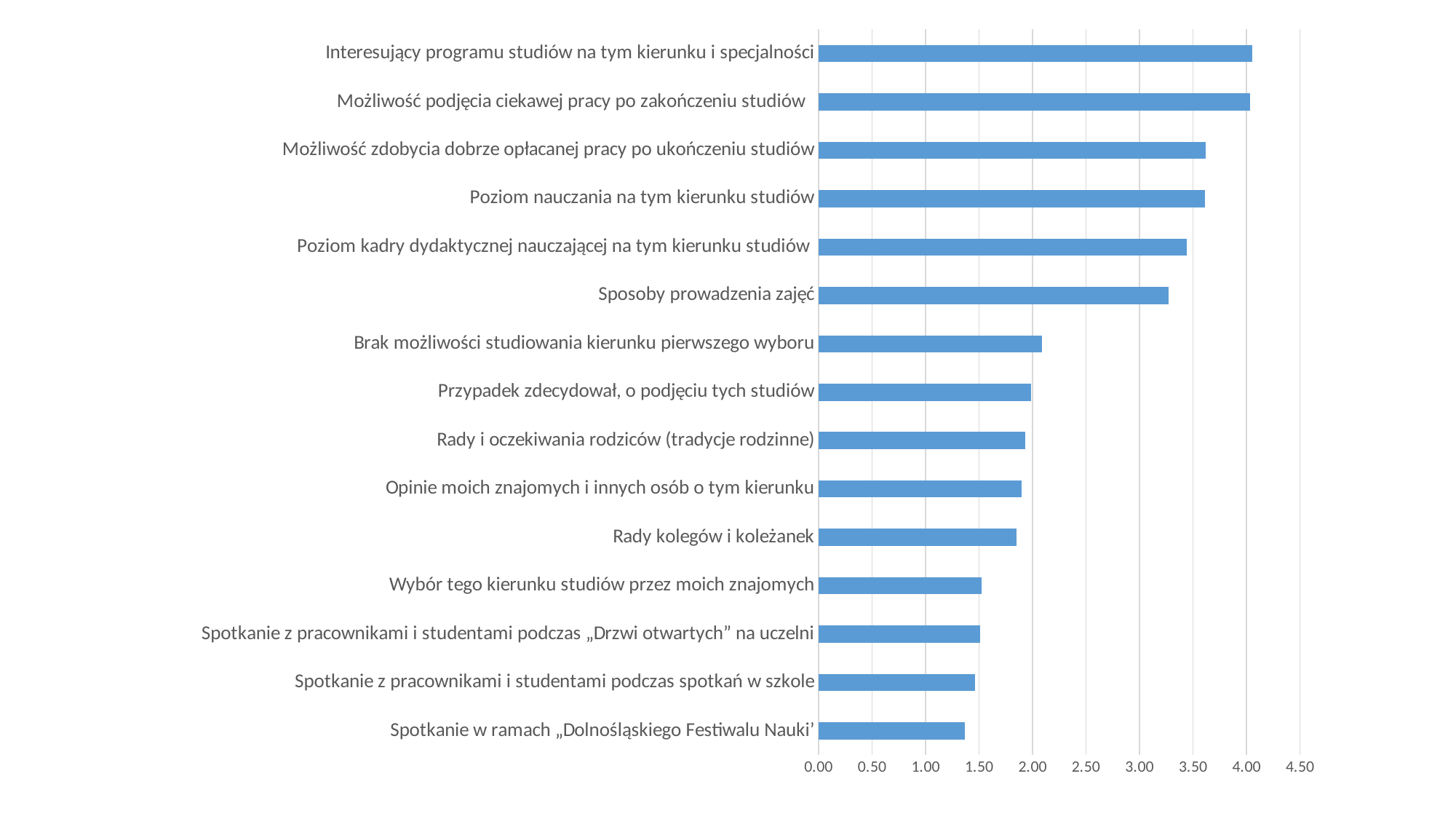
Which has a larger value: "Poziom kadry dydaktycznej nauczającej na tym kierunku studiów" or "Sposoby prowadzenia zajęć"? Poziom kadry dydaktycznej nauczającej na tym kierunku studiów Is the value for "Rady kolegów i koleżanek" greater or less than 2.00? less Which has a larger value: "Rady kolegów i koleżanek" or "Wybór tego kierunku studiów przez moich znajomych"? Rady kolegów i koleżanek Is the value for "Spotkanie z pracownikami i studentami podczas spotkań w szkole" greater or less than 1.00? greater Is the value for "Brak możliwości studiowania kierunku pierwszego wyboru" greater or less than 2.50? less Which has a larger value: "Sposoby prowadzenia zajęć" or "Brak możliwości studiowania kierunku pierwszego wyboru"? Sposoby prowadzenia zajęć What kind of chart is shown on the slide? bar chart What is the highest tick value shown on the horizontal axis? 4.50 How many categories are plotted in the chart? 15 Which category has the lowest value in the chart? Spotkanie w ramach „Dolnośląskiego Festiwalu Nauki'